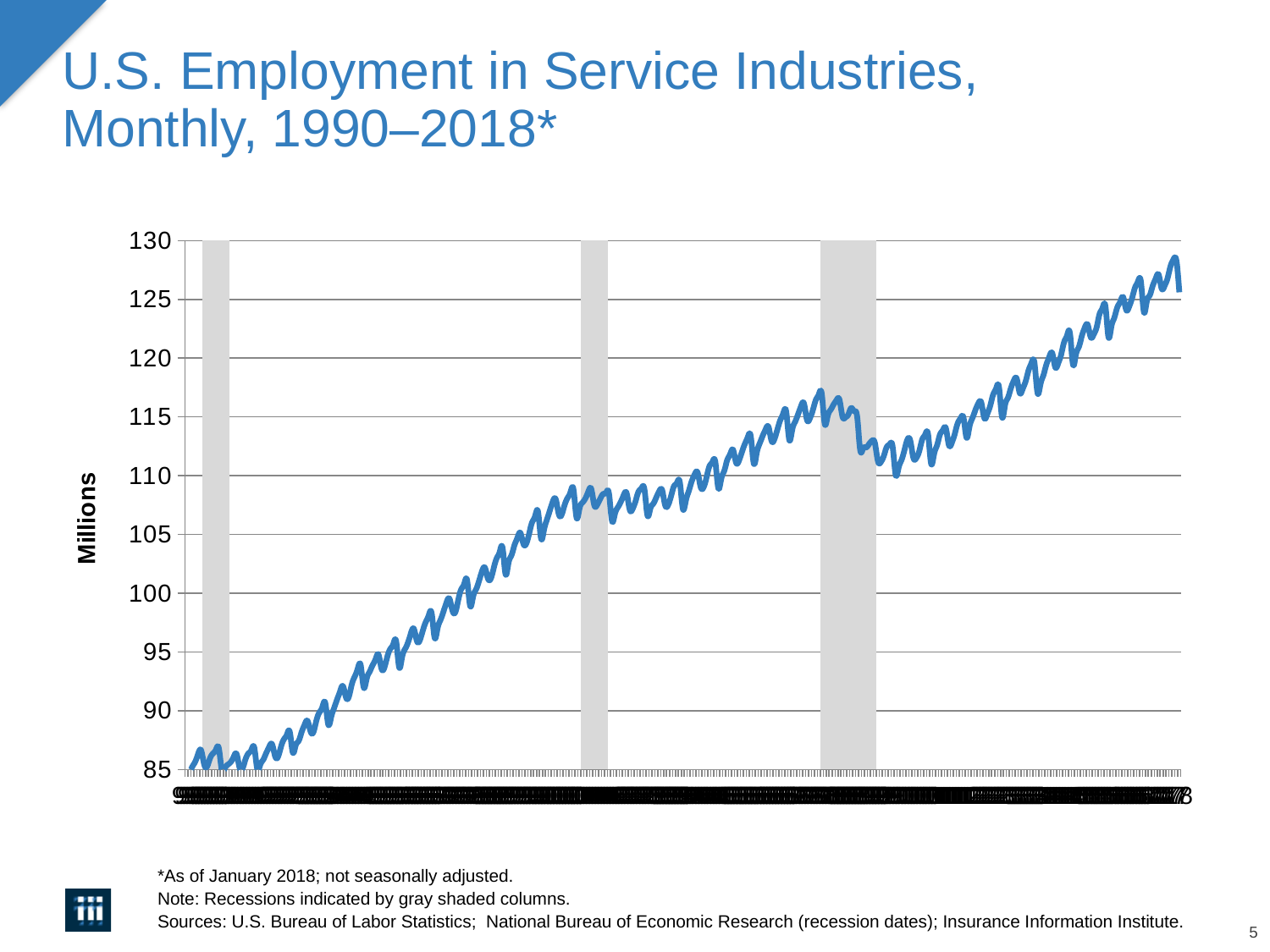
Is the value at the end of the series (right end of the line) greater or less than 120? greater What is the label on the vertical axis of the chart? Millions Is the value at the start of the series (left end of the line) greater or less than 90? less How many gray shaded recession columns appear on the chart? 3 Which is larger, the value at the start of the series or the value at the end of the series? the value at the end of the series Do the values generally rise or fall from left to right across the chart? rise Is the value of the line just before the third (rightmost) shaded recession column greater or less than 110? greater What is the title of the chart on the slide? U.S. Employment in Service Industries, Monthly, 1990–2018* What kind of chart is shown on the slide? line chart What is the highest tick value shown on the vertical axis? 130